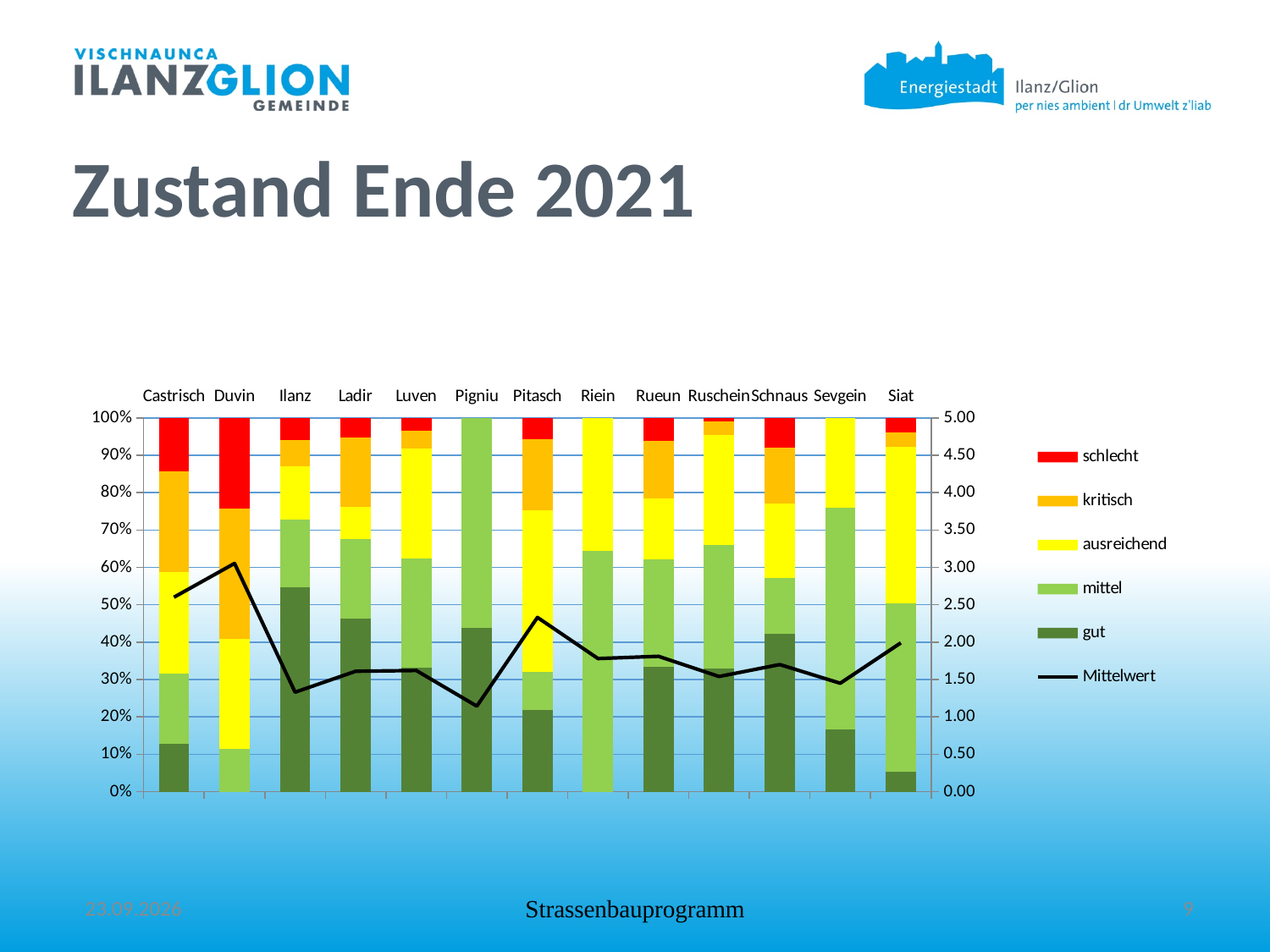
Which municipality has the largest 'schlecht' share, Duvin or Castrisch? Duvin Which municipality has the lowest Mittelwert value on the line? Pigniu Is the 'schlecht' share for Duvin greater or less than 20%? greater What is the title of the slide containing the chart? Zustand Ende 2021 Is the 'gut' share for Ilanz greater or less than 50%? greater Is the Mittelwert value for Pigniu greater or less than 1.50? less How many entries does the chart legend list? 6 Which municipality has the highest Mittelwert value on the line? Duvin What kind of chart is shown on the slide? combination bar and line chart How many municipalities (categories) are shown along the x axis of the chart? 13 Which municipality has the largest 'gut' share in the chart? Ilanz